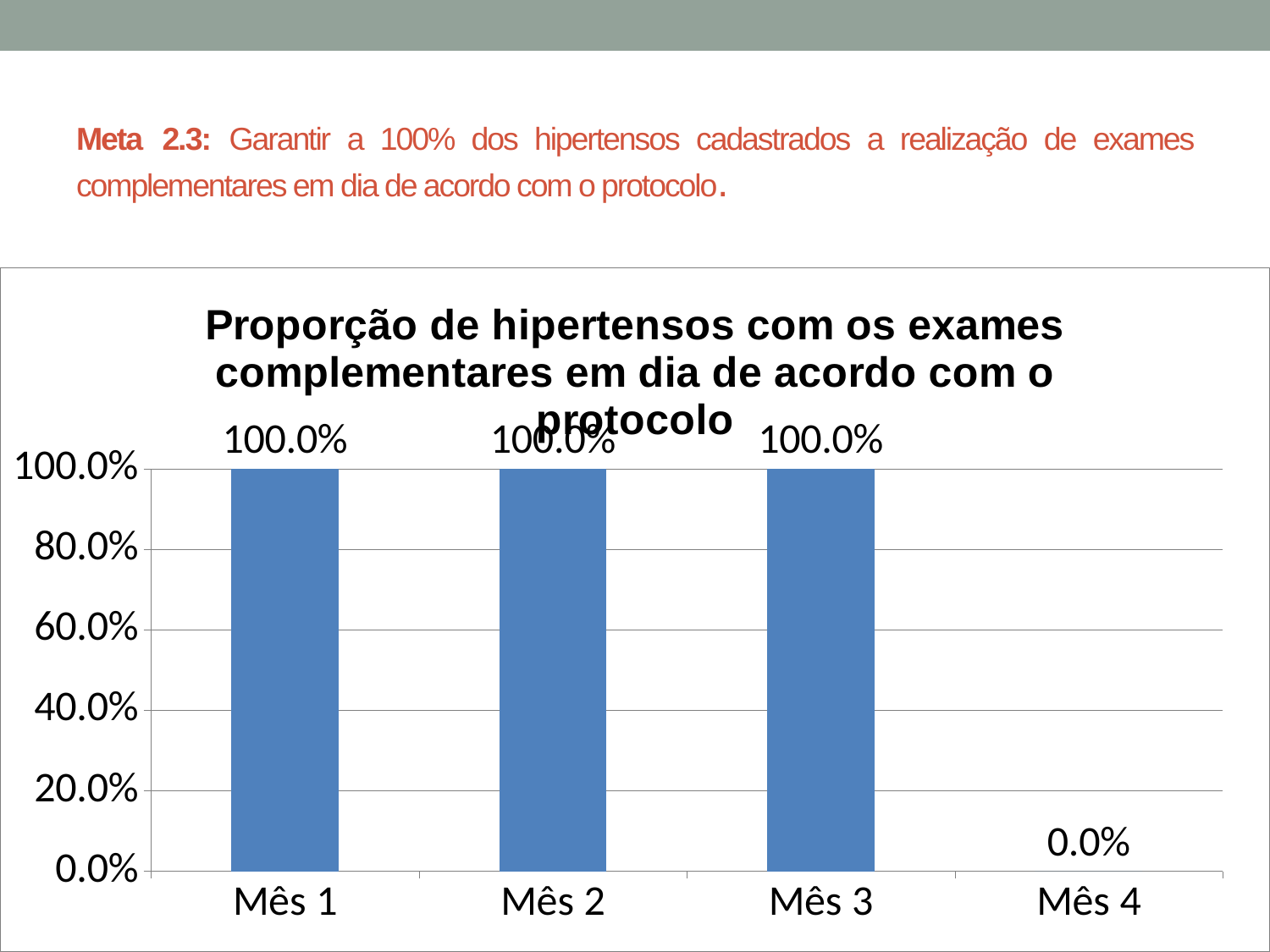
What is the value for Mês 4? 0.0% What kind of chart is shown on the slide? Bar chart What colour are the bars in the chart? Blue Which is larger, the value for Mês 3 or the value for Mês 4? Mês 3 What is the difference between the values for Mês 2 and Mês 4? 100.0% Is the value for Mês 2 greater or less than 80.0%? greater What is the value for Mês 1? 100.0% Which month has the lowest value? Mês 4 What is the value for Mês 3? 100.0% Do the values rise or fall from Mês 3 to Mês 4? Fall How many months are shown on the x axis? 4 What is the title of the chart? Proporção de hipertensos com os exames complementares em dia de acordo com o protocolo